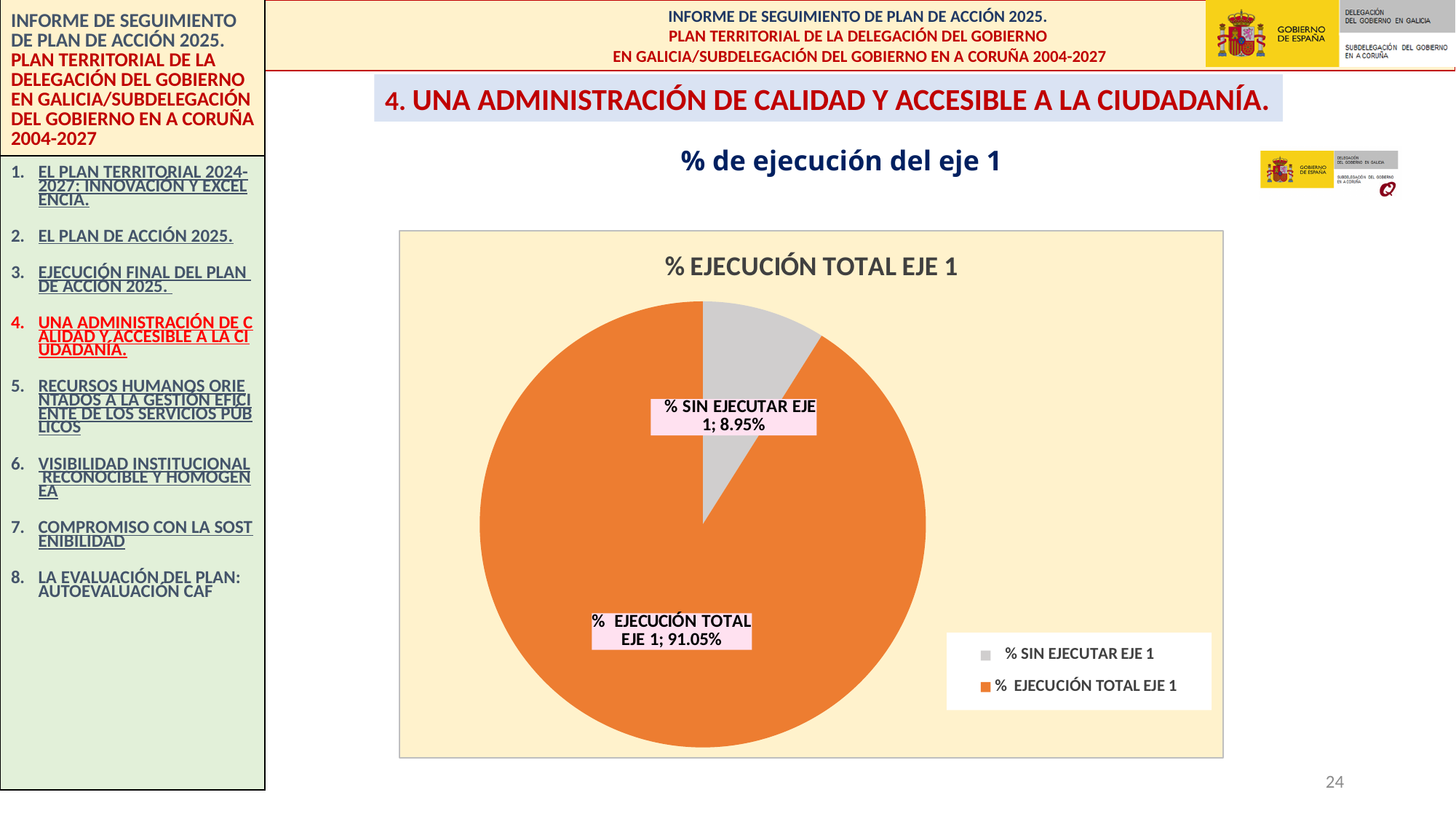
What is the difference between the % EJECUCIÓN TOTAL EJE 1 slice and the % SIN EJECUTAR EJE 1 slice? 82.10% Which slice of the pie is the largest? % EJECUCIÓN TOTAL EJE 1 How many slices does the pie chart have? 2 What colour is the % EJECUCIÓN TOTAL EJE 1 slice? orange What share of the pie does the % SIN EJECUTAR EJE 1 slice represent? 8.95% What value is shown for the slice labelled % EJECUCIÓN TOTAL EJE 1? 91.05% What type of chart is shown on the slide? pie chart What value is shown for the slice labelled % SIN EJECUTAR EJE 1? 8.95% How many entries does the legend list? 2 What is the title of the chart? % EJECUCIÓN TOTAL EJE 1 Which is larger, the % SIN EJECUTAR EJE 1 slice or the % EJECUCIÓN TOTAL EJE 1 slice? % EJECUCIÓN TOTAL EJE 1 Which slice of the pie is the smallest? % SIN EJECUTAR EJE 1